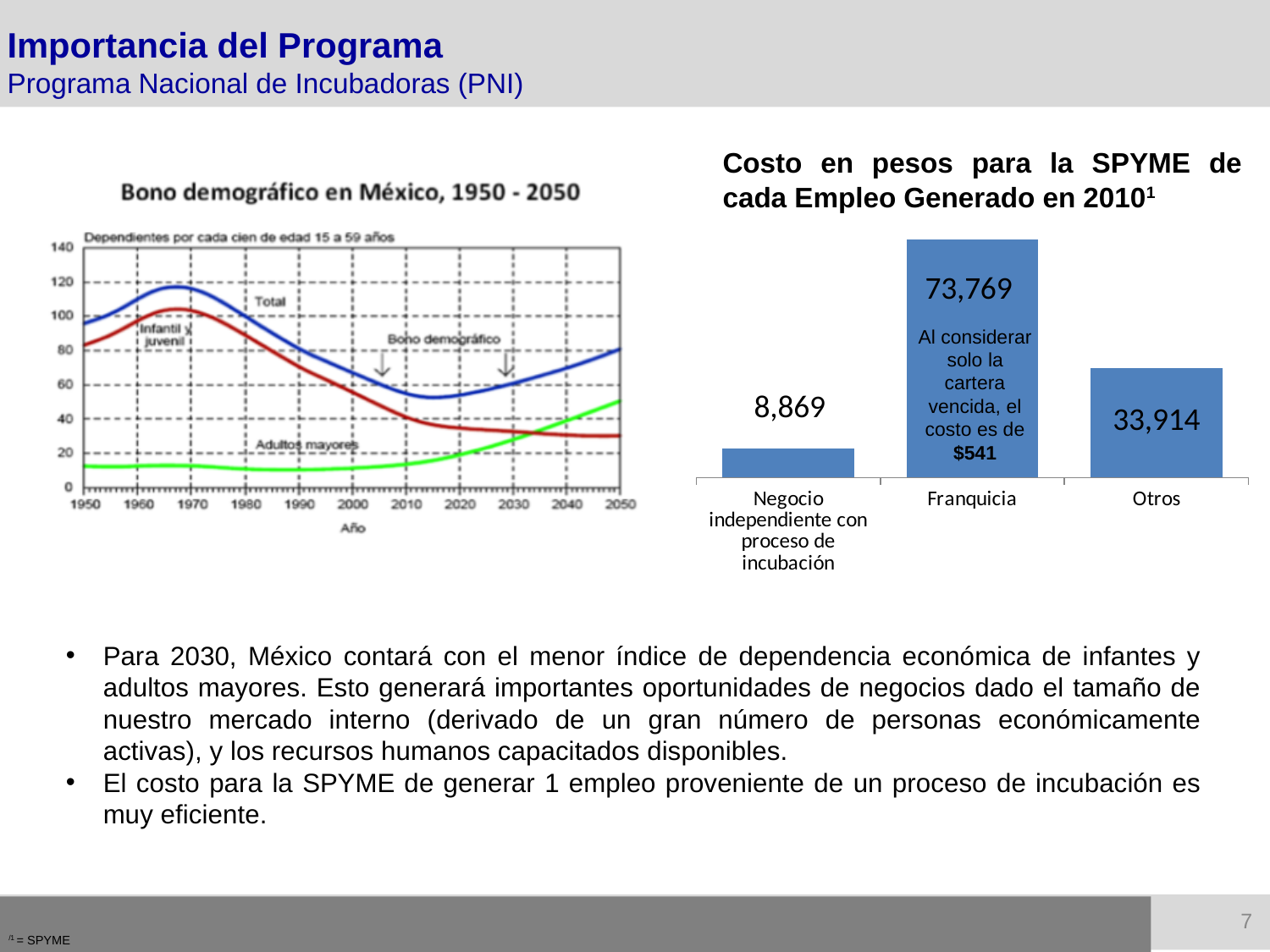
In the chart 'Costo en pesos para la SPYME de cada Empleo Generado en 2010', what is the value for 'Negocio independiente con proceso de incubación'? 8,869 What kind of chart is 'Bono demográfico en México, 1950 - 2050'? Line chart In the chart 'Costo en pesos para la SPYME de cada Empleo Generado en 2010', which category has the highest value? Franquicia In the chart 'Costo en pesos para la SPYME de cada Empleo Generado en 2010', what is the difference between the values for Franquicia and Otros? 39,855 In the chart 'Costo en pesos para la SPYME de cada Empleo Generado en 2010', how many categories are shown? 3 In the chart 'Costo en pesos para la SPYME de cada Empleo Generado en 2010', which category has the lowest value? Negocio independiente con proceso de incubación In the chart 'Costo en pesos para la SPYME de cada Empleo Generado en 2010', what is the value for Franquicia? 73,769 In the chart 'Costo en pesos para la SPYME de cada Empleo Generado en 2010', what is the value for Otros? 33,914 In the chart 'Bono demográfico en México, 1950 - 2050', how many lines are plotted? 3 In the chart 'Bono demográfico en México, 1950 - 2050', does the 'Adultos mayores' line rise or fall between 2010 and 2050? Rise What kind of chart is 'Costo en pesos para la SPYME de cada Empleo Generado en 2010'? Bar chart